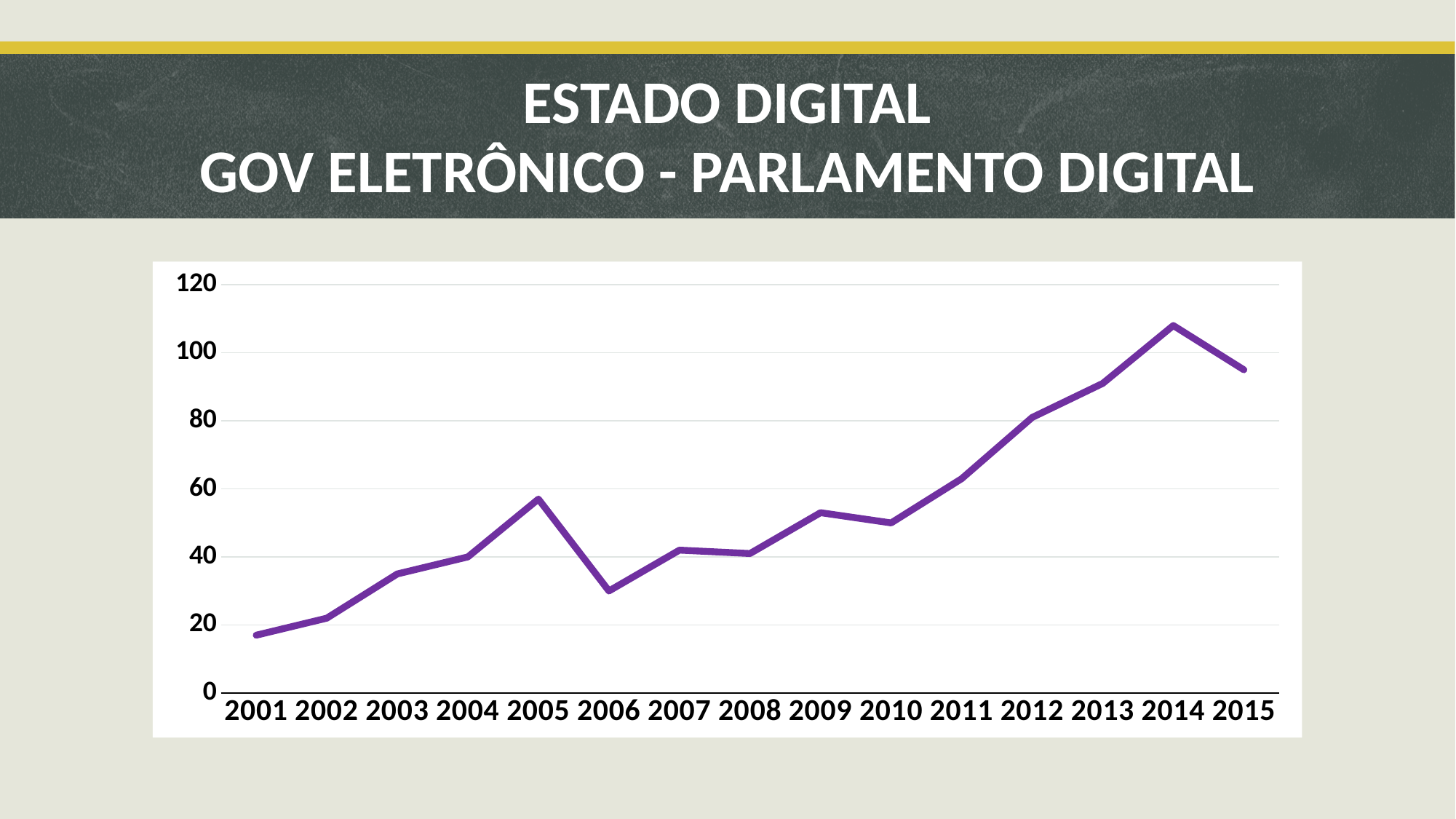
Is the value for 2014 greater or less than 100? greater Is the value for 2015 greater or less than 100? less Does the value rise or fall from 2014 to 2015? fall Is the value for 2013 greater or less than 80? greater Which year has the highest value? 2014 What colour is the plotted line? purple What kind of chart is shown on the slide? line chart Which year has the lowest value? 2001 How many years are plotted along the x axis? 15 Which is larger, the value for 2005 or the value for 2006? 2005